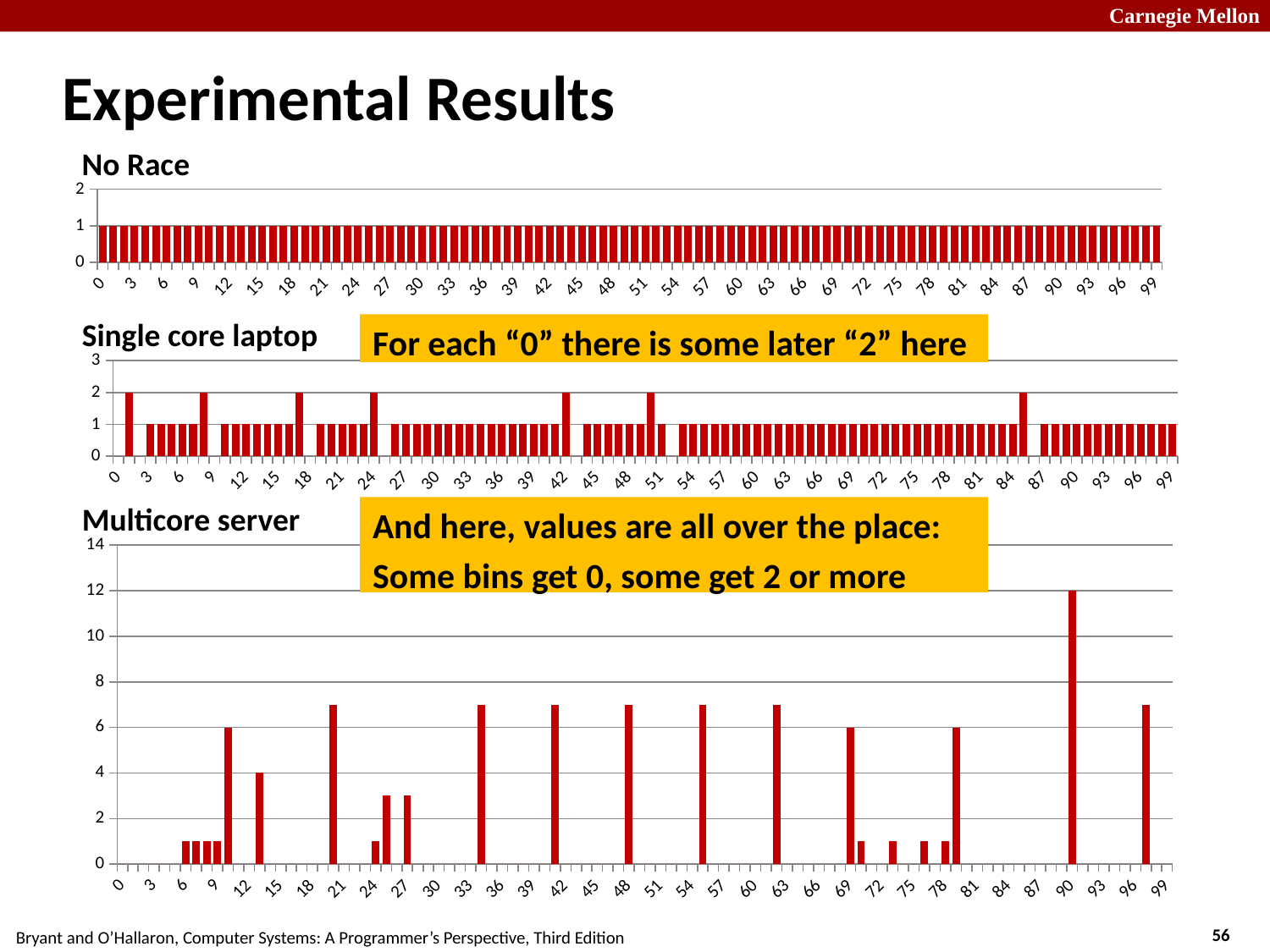
What kind of chart is the "No Race" chart? bar chart In the "No Race" chart, do the values rise, fall, or stay constant across the bins? stay constant In the "Multicore server" chart, what is the value for bin 90? 12 How many charts are shown on the slide? 3 In the "Multicore server" chart, which bin has the highest value? 90 In the "Multicore server" chart, is the value for bin 20 greater or less than 8? less In the "Single core laptop" chart, what is the top value shown on the y axis? 3 In the "Multicore server" chart, what is the value for bin 10? 6 In the "Single core laptop" chart, what is the highest value reached by any bar? 2 In the "Multicore server" chart, what is the difference between the value for bin 90 and the value for bin 10? 6 In the "No Race" chart, what is the value for bin 0? 1 In the "Multicore server" chart, what is the value for bin 13? 4